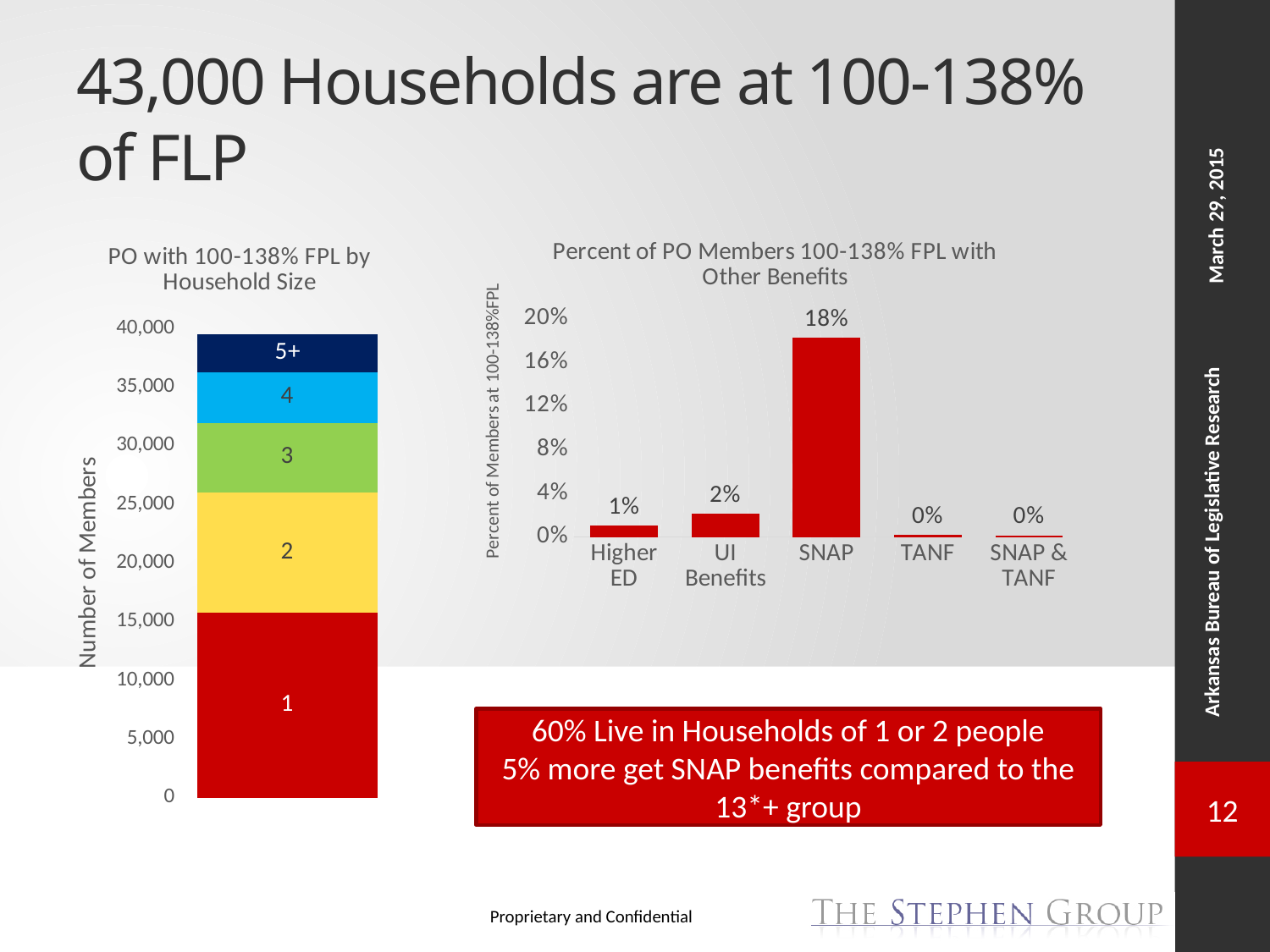
In the chart 'Percent of PO Members 100-138% FPL with Other Benefits', what is the value for UI Benefits? 2% In the chart 'PO with 100-138% FPL by Household Size', how many household size segments make up the stacked bar? 5 In the chart 'Percent of PO Members 100-138% FPL with Other Benefits', what is the difference between the SNAP value and the UI Benefits value? 16% How many benefit categories are shown in the chart 'Percent of PO Members 100-138% FPL with Other Benefits'? 5 In the chart 'PO with 100-138% FPL by Household Size', is the total height of the stacked bar greater or less than 35,000? greater In the chart 'Percent of PO Members 100-138% FPL with Other Benefits', which is larger, the value for UI Benefits or the value for Higher ED? UI Benefits In the chart 'Percent of PO Members 100-138% FPL with Other Benefits', what percent of members receive SNAP? 18% In the chart 'Percent of PO Members 100-138% FPL with Other Benefits', what is the value for Higher ED? 1% In the chart 'Percent of PO Members 100-138% FPL with Other Benefits', what is the value for TANF? 0% What kind of chart is 'PO with 100-138% FPL by Household Size'? Stacked bar chart In the chart 'Percent of PO Members 100-138% FPL with Other Benefits', which benefit category has the highest value? SNAP In the chart 'PO with 100-138% FPL by Household Size', which household size segment is the largest? 1